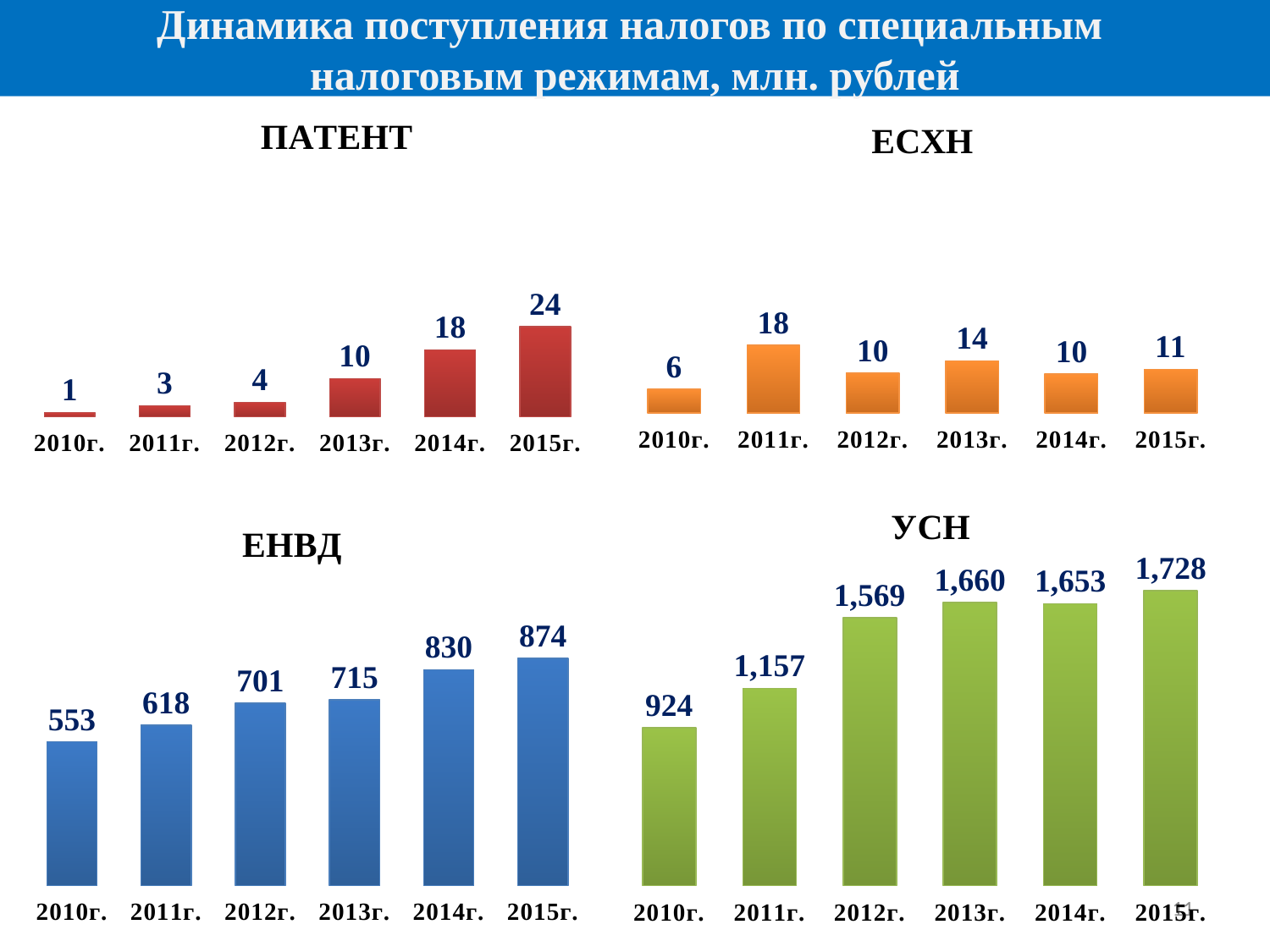
What colour are the bars in the ЕНВД chart? blue What type of chart is the ЕСХН chart? bar chart In the УСН chart, which year has the lowest value? 2010г. In the УСН chart, which is larger, the value for 2013г. or 2014г.? 2013г. How many years are shown in the ЕНВД chart? 6 In the ПАТЕНТ chart, do the values rise or fall from 2010г. to 2015г.? rise In the ЕСХН chart, which year has the highest value? 2011г. In the ПАТЕНТ chart, what is the value for 2015г.? 24 In the ЕСХН chart, what is the value for 2013г.? 14 In the ЕНВД chart, what is the value for 2012г.? 701 In the УСН chart, what is the value for 2014г.? 1,653 In the ЕНВД chart, what is the difference between the 2015г. and 2010г. values? 321